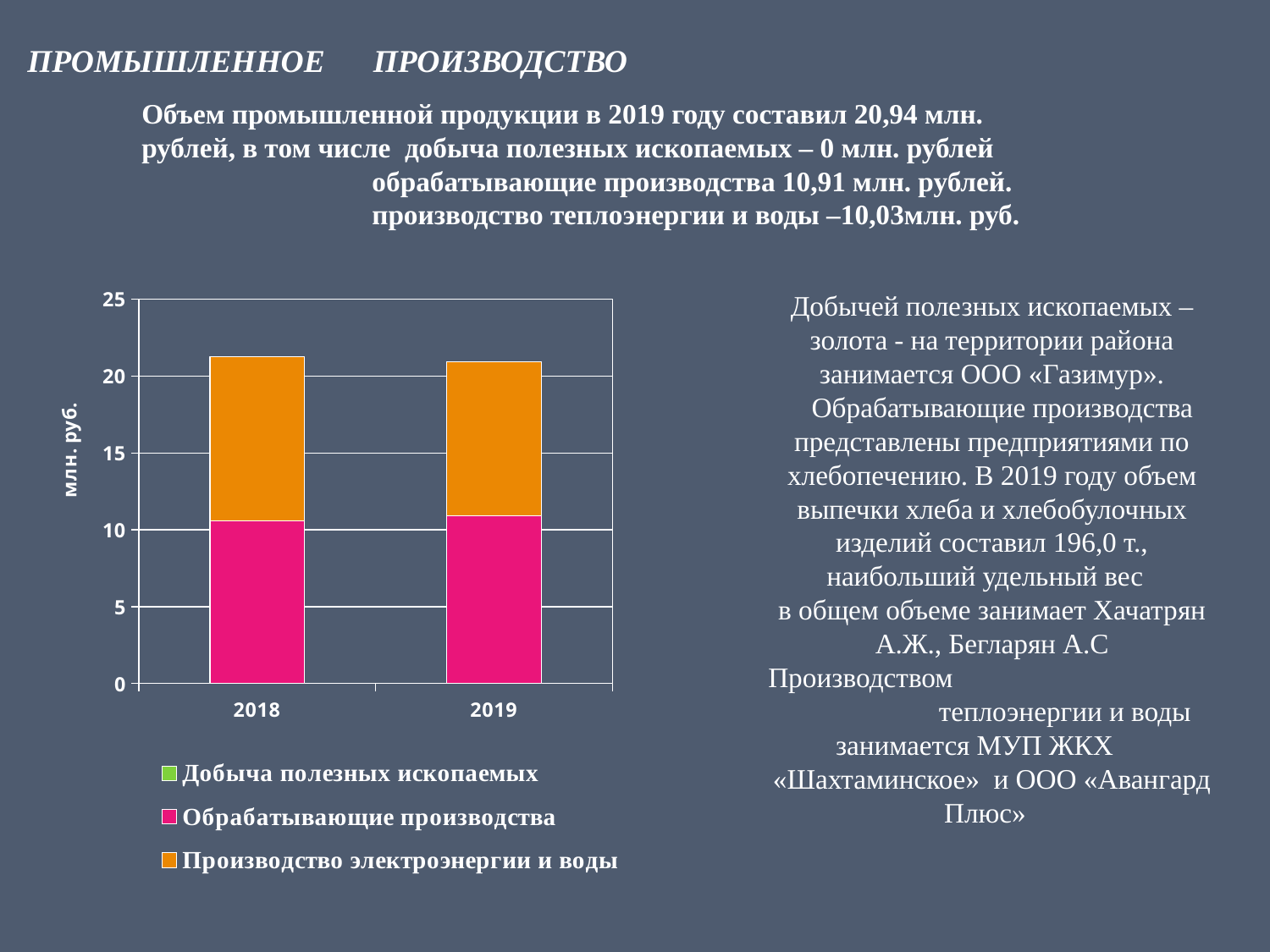
Is the value of "Обрабатывающие производства" for 2018 greater or less than 10? greater Is the total height of the stacked bar for 2019 greater or less than 25? less What colour represents "Обрабатывающие производства" in the chart? pink What is the label of the vertical axis of the chart? млн. руб. What kind of chart is shown on the slide? stacked bar chart How many series does the chart legend list? 3 Is the total height of the stacked bar for 2019 greater or less than 20? greater Which series has the smallest value in the 2018 bar? Добыча полезных ископаемых Which series has the smallest value in the 2019 bar? Добыча полезных ископаемых How many years (categories) are shown on the x axis of the chart? 2